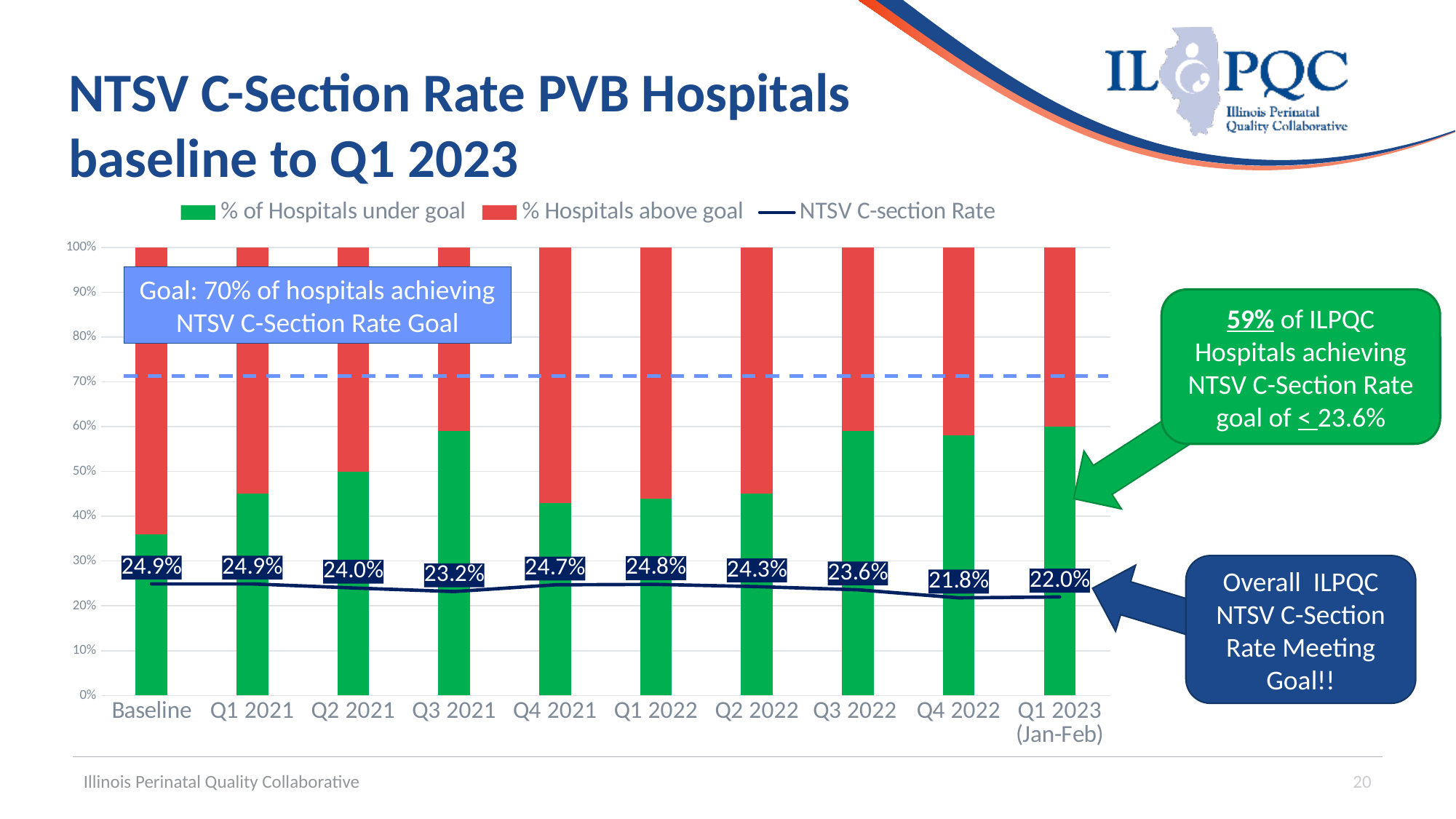
What kind of chart is used for the % of Hospitals under goal and % Hospitals above goal series? Stacked bar chart How many periods are shown on the x axis? 10 What is the NTSV C-section Rate shown for Q1 2023 (Jan-Feb)? 22.0% What is the difference between the NTSV C-section Rate at Baseline and in Q1 2023 (Jan-Feb)? 2.9 percentage points How many series does the legend list? 3 Does the NTSV C-section Rate generally rise or fall from Baseline to Q1 2023 (Jan-Feb)? Fall Which has a higher NTSV C-section Rate, Q1 2022 or Q3 2022? Q1 2022 Is the % of Hospitals under goal in Q3 2021 greater or less than 50%? greater What is the NTSV C-section Rate shown for Q3 2021? 23.2% Is the % of Hospitals under goal at Baseline greater or less than 40%? less Which period has the lowest NTSV C-section Rate? Q4 2022 What is the NTSV C-section Rate shown for Q4 2022? 21.8%